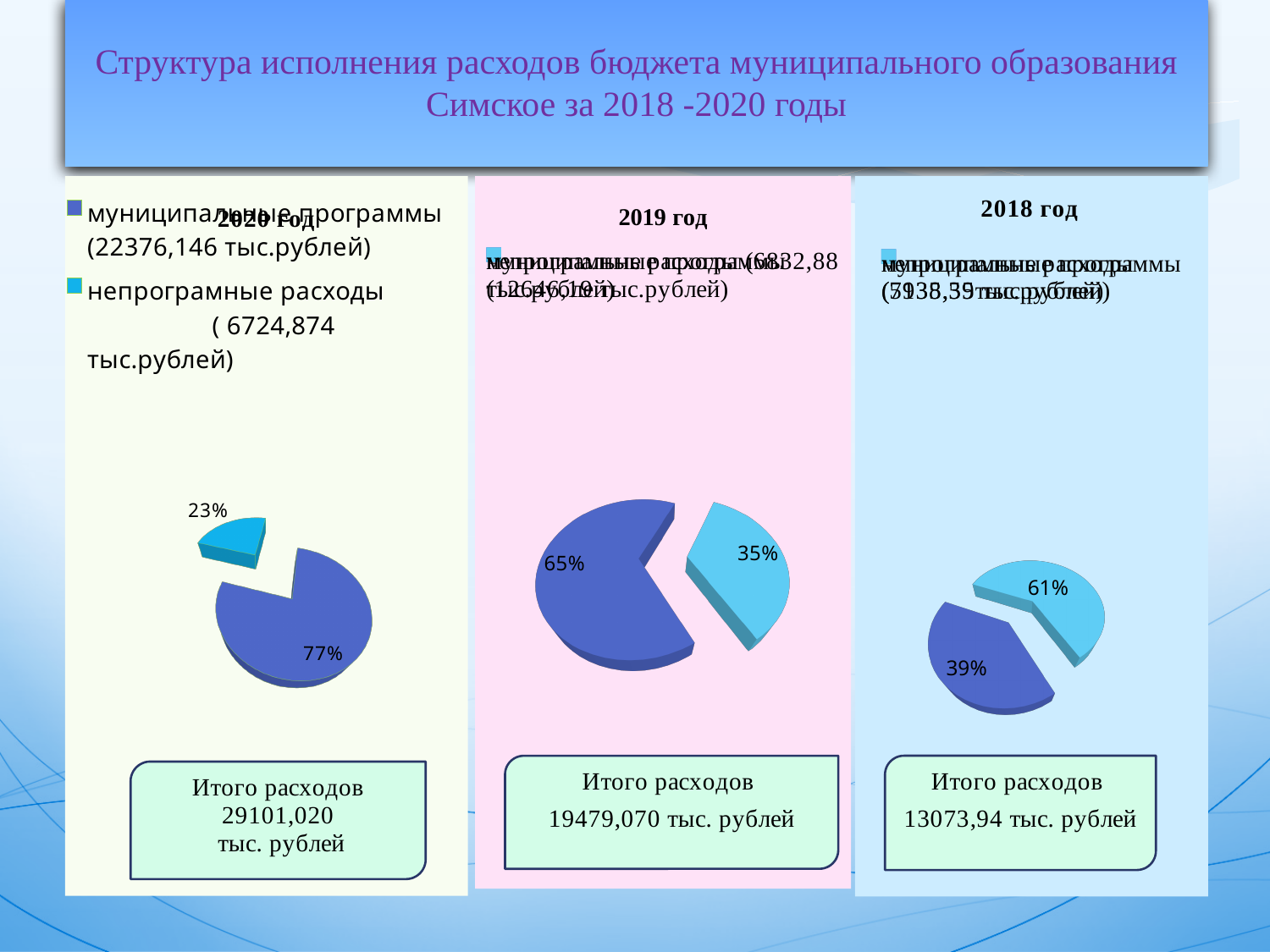
In the 2020 год panel, how many entries does the legend list? 2 In the 2020 год pie chart, what share does the smaller, light blue slice have? 23% How many pie charts are shown on the slide? 3 In the 2020 год pie chart, what is the difference between the two slices' shares? 54% In the 2020 год pie chart, what share does the larger slice have? 77% How many slices does the 2019 год pie chart have? 2 In the 2018 год pie chart, what share does the light blue slice have? 61% In the 2019 год pie chart, what share does the light blue slice have? 35% In the 2018 год pie chart, what share does the dark blue slice have? 39% In the 2019 год pie chart, what share does the dark blue slice have? 65% What kind of chart is used for the 2020 год panel? pie chart In the 2018 год pie chart, which slice is larger, the light blue one or the dark blue one? the light blue one